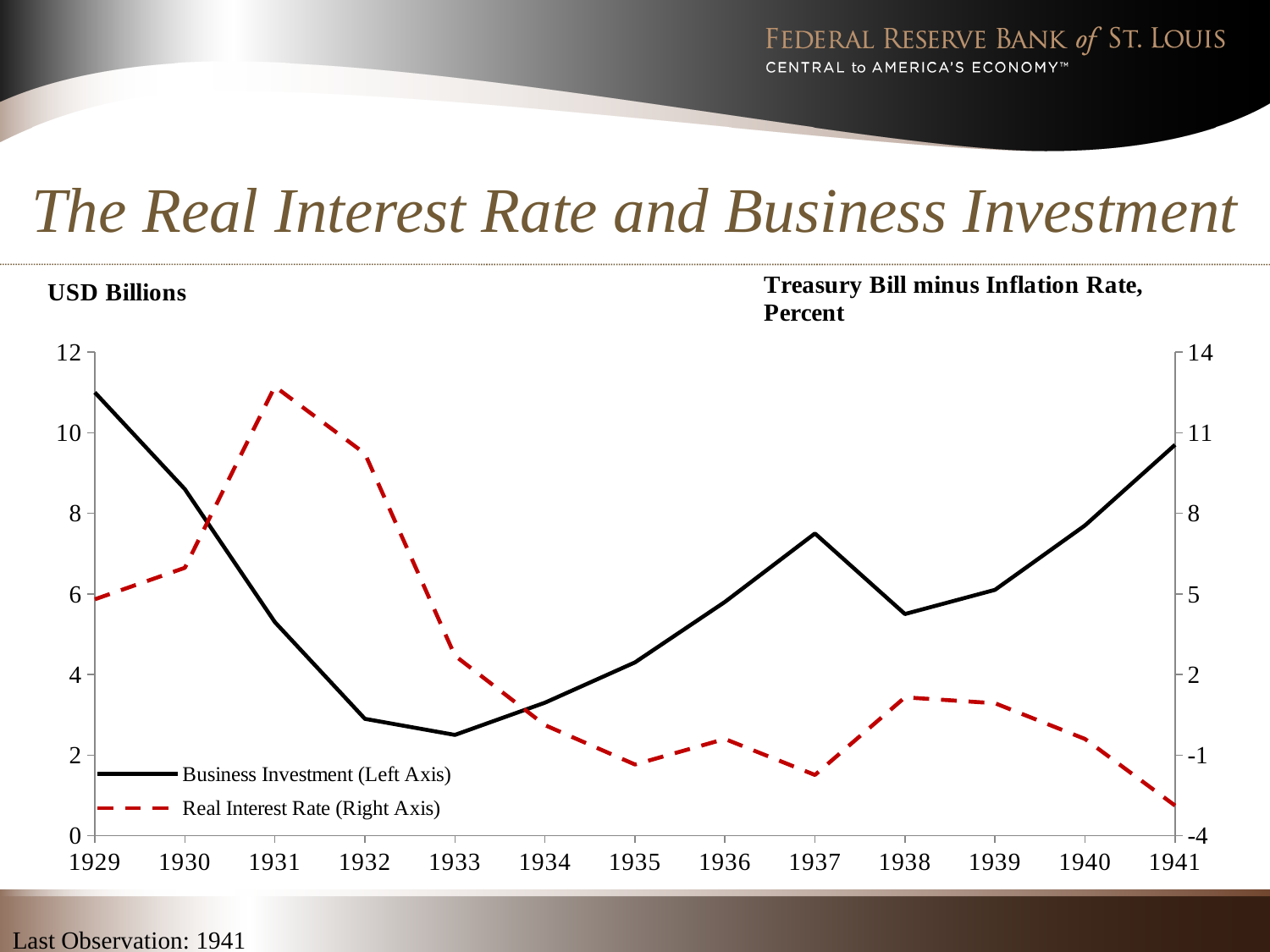
How many years are labelled on the x axis? 13 Is the value for Business Investment in 1941 greater or less than 8? greater In which year is the Real Interest Rate lowest? 1941 In which year is Business Investment lowest? 1933 How many series does the legend list? 2 What kind of chart is shown on the slide? line chart Is the value for Business Investment in 1932 greater or less than 4? less Is the value for the Real Interest Rate in 1931 greater or less than 11? greater Does Business Investment rise or fall from 1933 to 1937? rise In which year does the Real Interest Rate reach its peak? 1931 Which year has higher Business Investment, 1937 or 1938? 1937 In which year is Business Investment highest? 1929